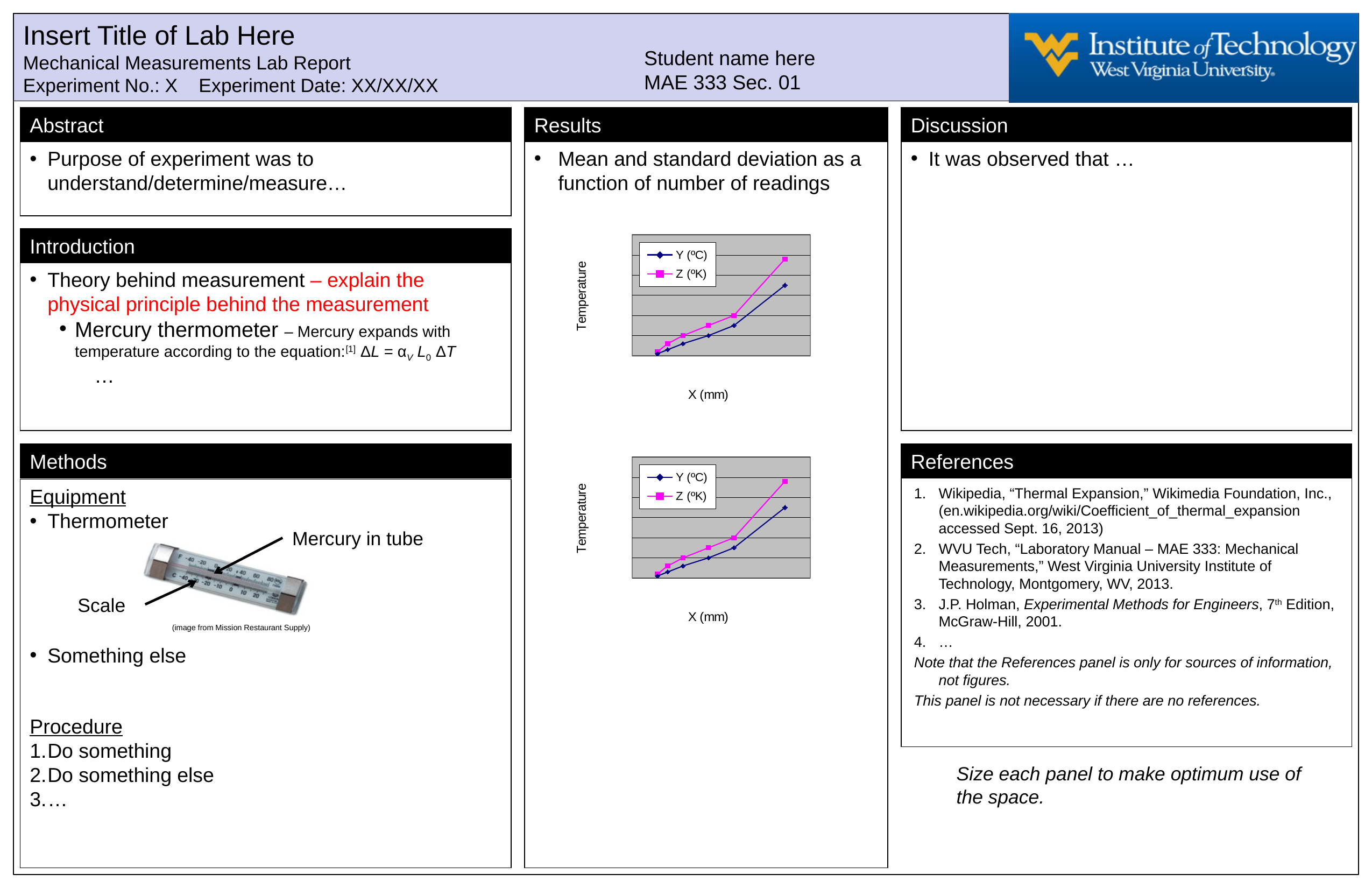
What kind of chart is the bottom chart in the Results panel? line chart How many series does the legend of the bottom chart list? 2 In the bottom chart, do the values of the Z (ºK) series rise or fall along the x axis? rise In the bottom chart, which series has the higher value at the rightmost point, Y (ºC) or Z (ºK)? Z (ºK) What kind of chart is the top chart in the Results panel? line chart How many series does the legend of the top chart list? 2 How many data points are plotted for the Y (ºC) series in the top chart? 6 What is the y-axis title of the bottom chart? Temperature In the top chart, which series has the higher value at the rightmost point, Y (ºC) or Z (ºK)? Z (ºK) In the top chart, do the values of the Y (ºC) series rise or fall along the x axis? rise What is the x-axis title of the top chart? X (mm)